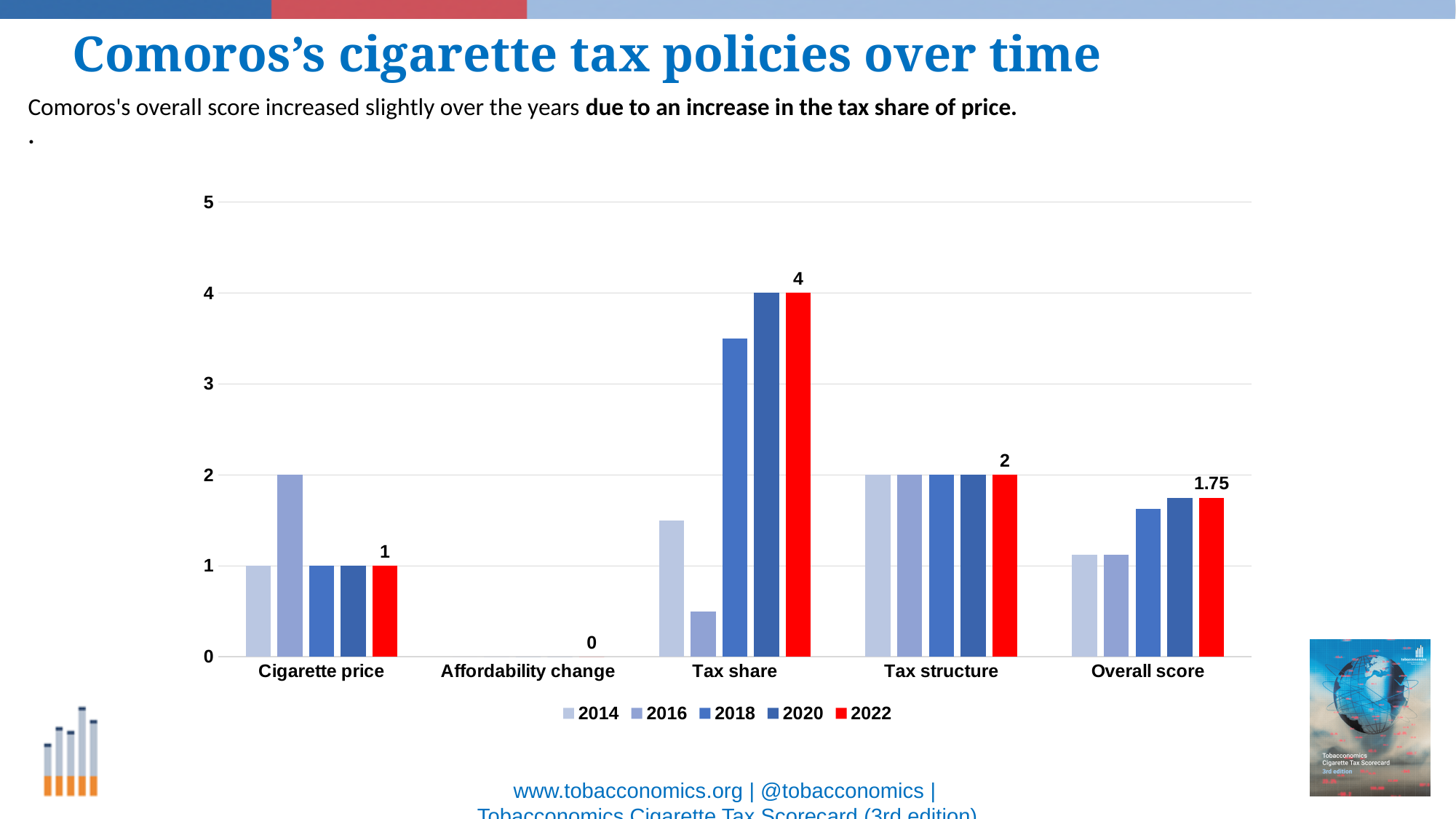
How many series does the legend list? 5 What is the value for Tax share in 2022? 4 Is the value for Tax share in 2018 greater or less than 3? greater What is the difference between the 2022 values for Tax share and Tax structure? 2 Is the value for Tax share in 2016 greater or less than 1? less What is the value for Affordability change in 2022? 0 Which category has the lowest value in 2022? Affordability change Which category has the highest value in 2022? Tax share What kind of chart is shown on the slide? bar chart In 2022, which is larger: Tax share or Cigarette price? Tax share What is the Overall score for 2022? 1.75 What is the value for Cigarette price in 2016? 2